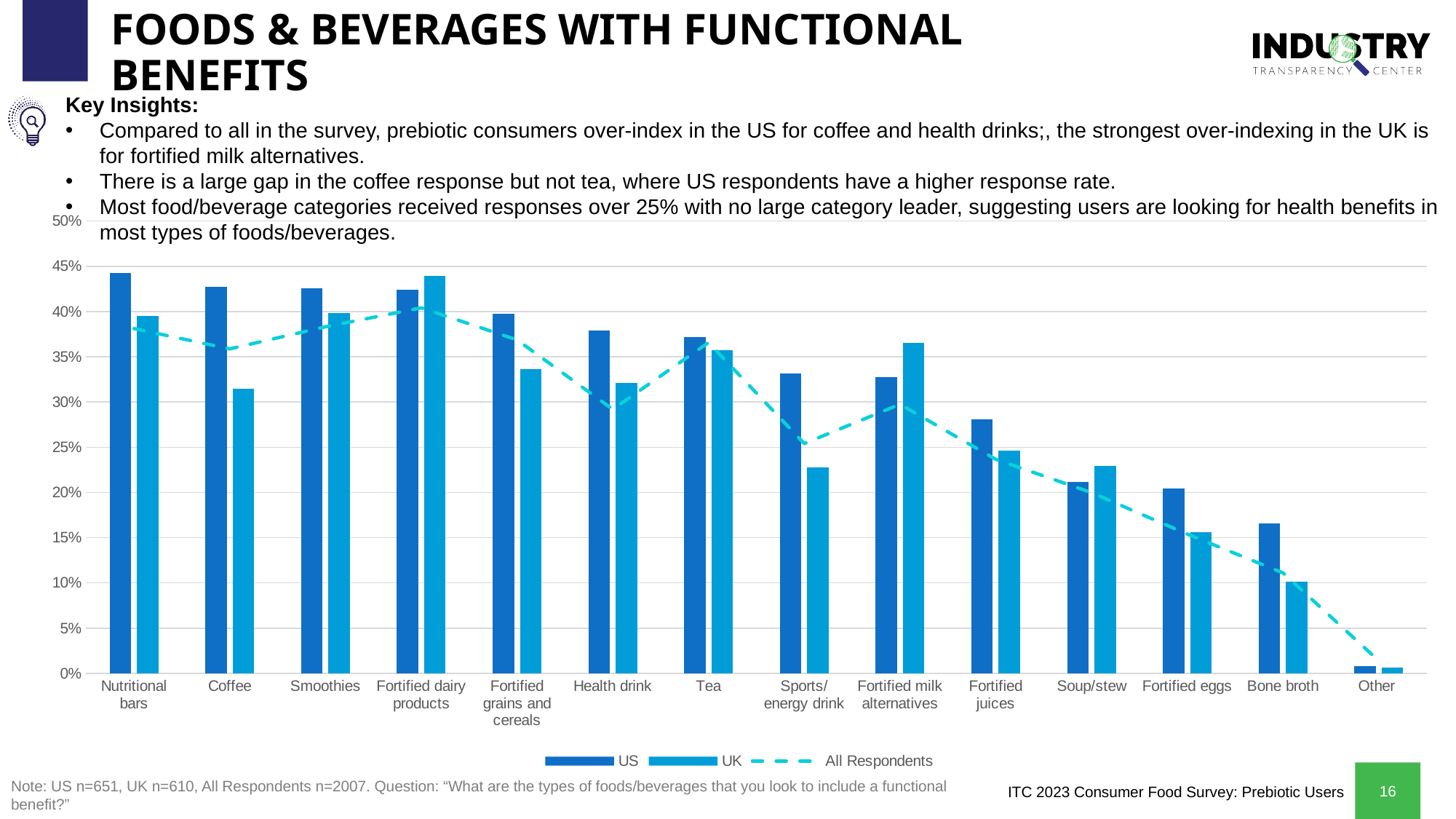
Which category has the highest UK value? Fortified dairy products How many food/beverage categories are shown on the x axis of the chart? 14 Which category has the lowest US value? Other How many series does the chart's legend list? 3 Is the US value for Bone broth greater or less than 15%? greater Is the US value for Coffee greater or less than 40%? greater For Coffee, which is larger, the US value or the UK value? US For Fortified milk alternatives, which is larger, the US value or the UK value? UK Which series in the legend is drawn as a dashed line? All Respondents Is the UK value for Sports/energy drink greater or less than 25%? less Do the US values generally rise or fall moving from left to right across the categories? fall What kind of chart is shown on the slide? combination bar and line chart